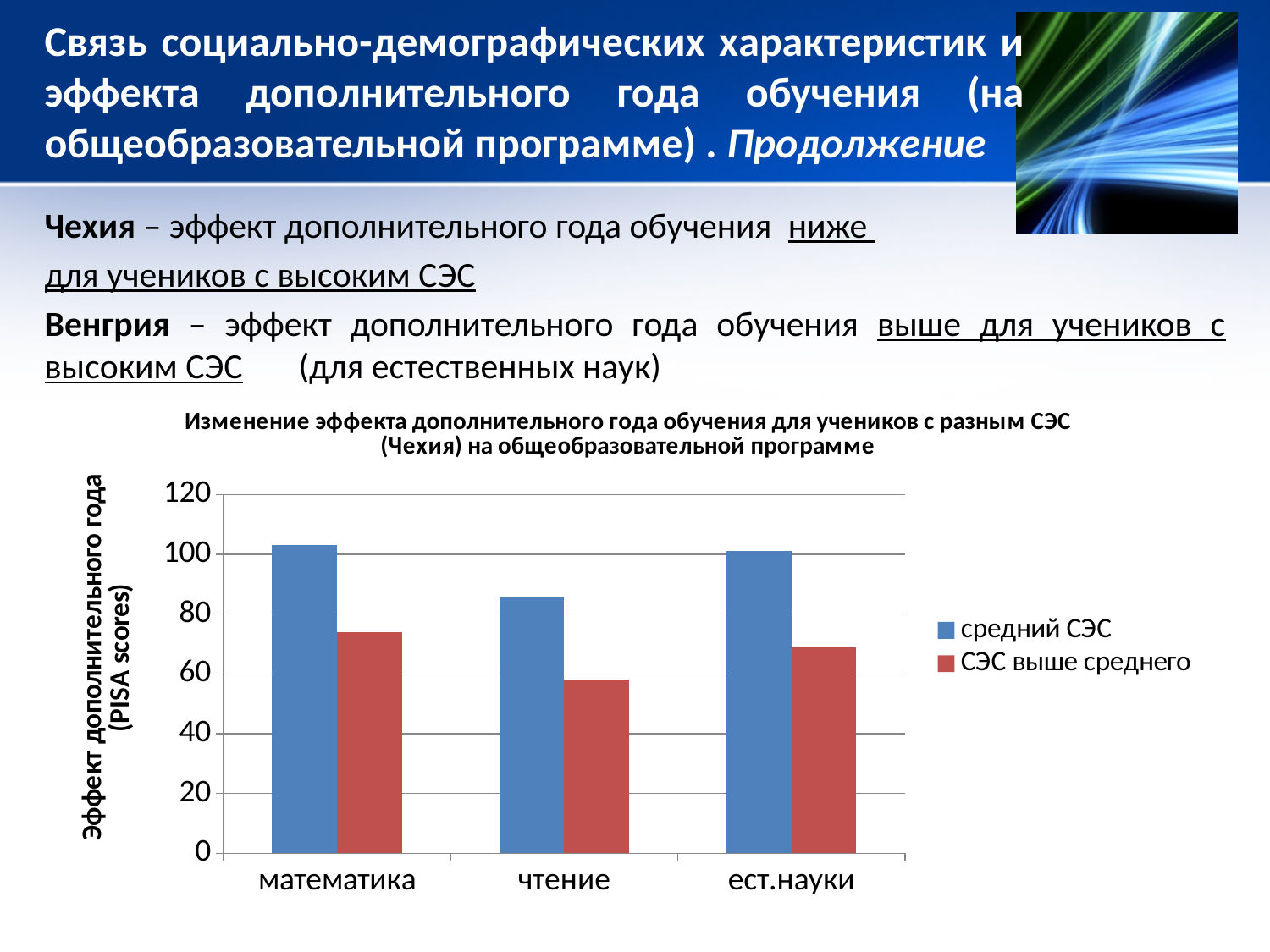
For 'математика', which series has the larger value: 'средний СЭС' or 'СЭС выше среднего'? средний СЭС Is the value for 'ест.науки' in the series 'СЭС выше среднего' greater or less than 60? greater What kind of chart is shown on the slide? bar chart Is the value for 'математика' in the series 'СЭС выше среднего' greater or less than 80? less Which category has the lowest value for the series 'СЭС выше среднего'? чтение For 'ест.науки', which series has the larger value: 'средний СЭС' or 'СЭС выше среднего'? средний СЭС Is the value for 'математика' in the series 'средний СЭС' greater or less than 100? greater Which category has the lowest value for the series 'средний СЭС'? чтение How many series does the chart legend list? 2 What is the label of the vertical axis of the chart? Эффект дополнительного года (PISA scores) How many categories are shown on the x axis of the chart? 3